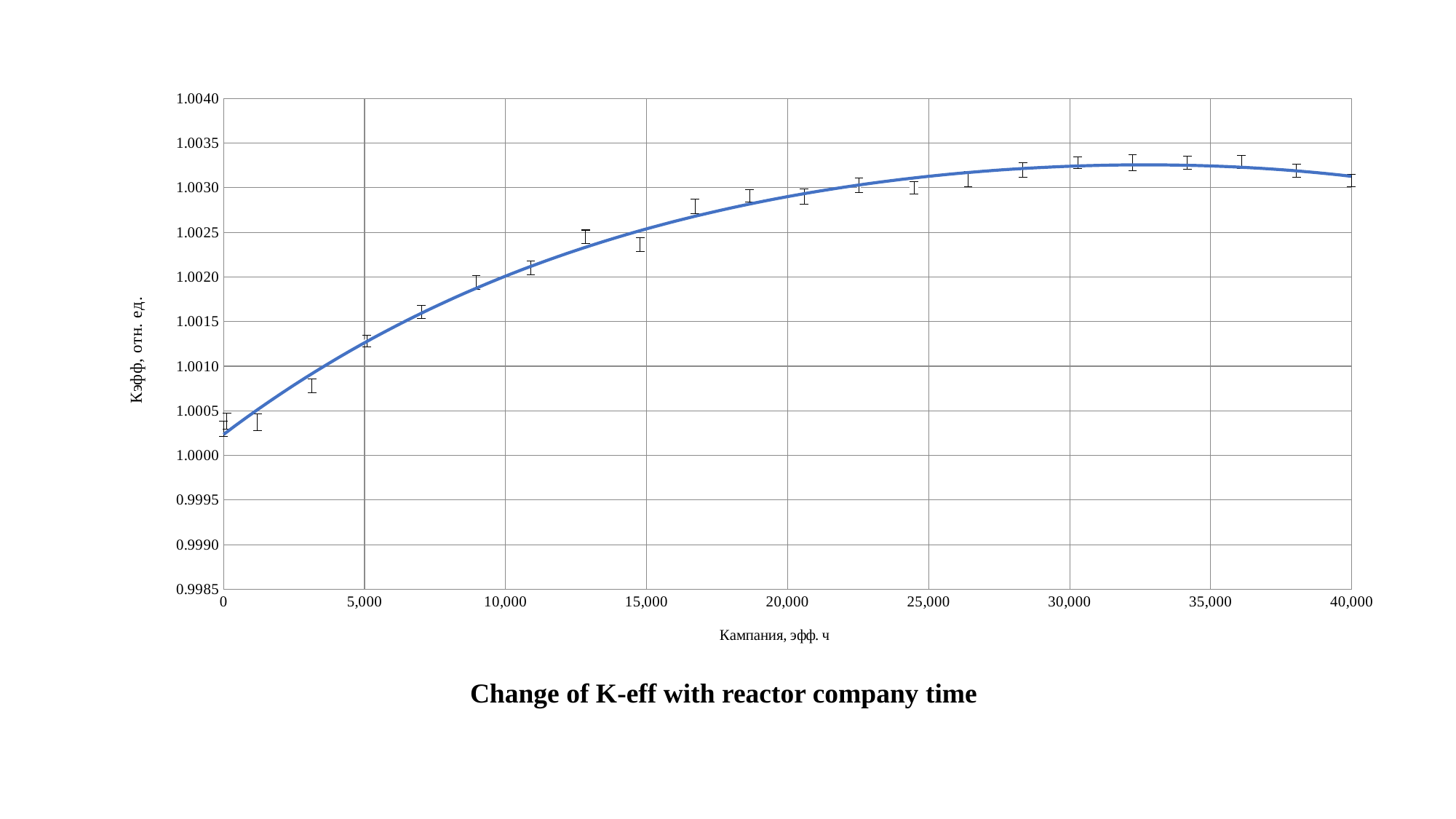
What is the label of the vertical axis? Кэфф, отн. ед. What kind of chart is shown on the slide? line chart Is the value of the curve at 20,000 greater or less than 1.0025? greater Is the value of the curve at 0 greater or less than 1.0010? less What is the title of the chart? Change of K-eff with reactor company time Which is larger, the value of the curve at 5,000 or at 35,000? 35,000 Is the value of the curve at 35,000 greater or less than 1.0030? greater Which is larger, the value of the curve at 0 or at 40,000? 40,000 What is the highest tick value shown on the x axis? 40,000 Does the curve rise or fall between 0 and 20,000 on the x axis? rise Does the curve rise or fall between 35,000 and 40,000 on the x axis? fall